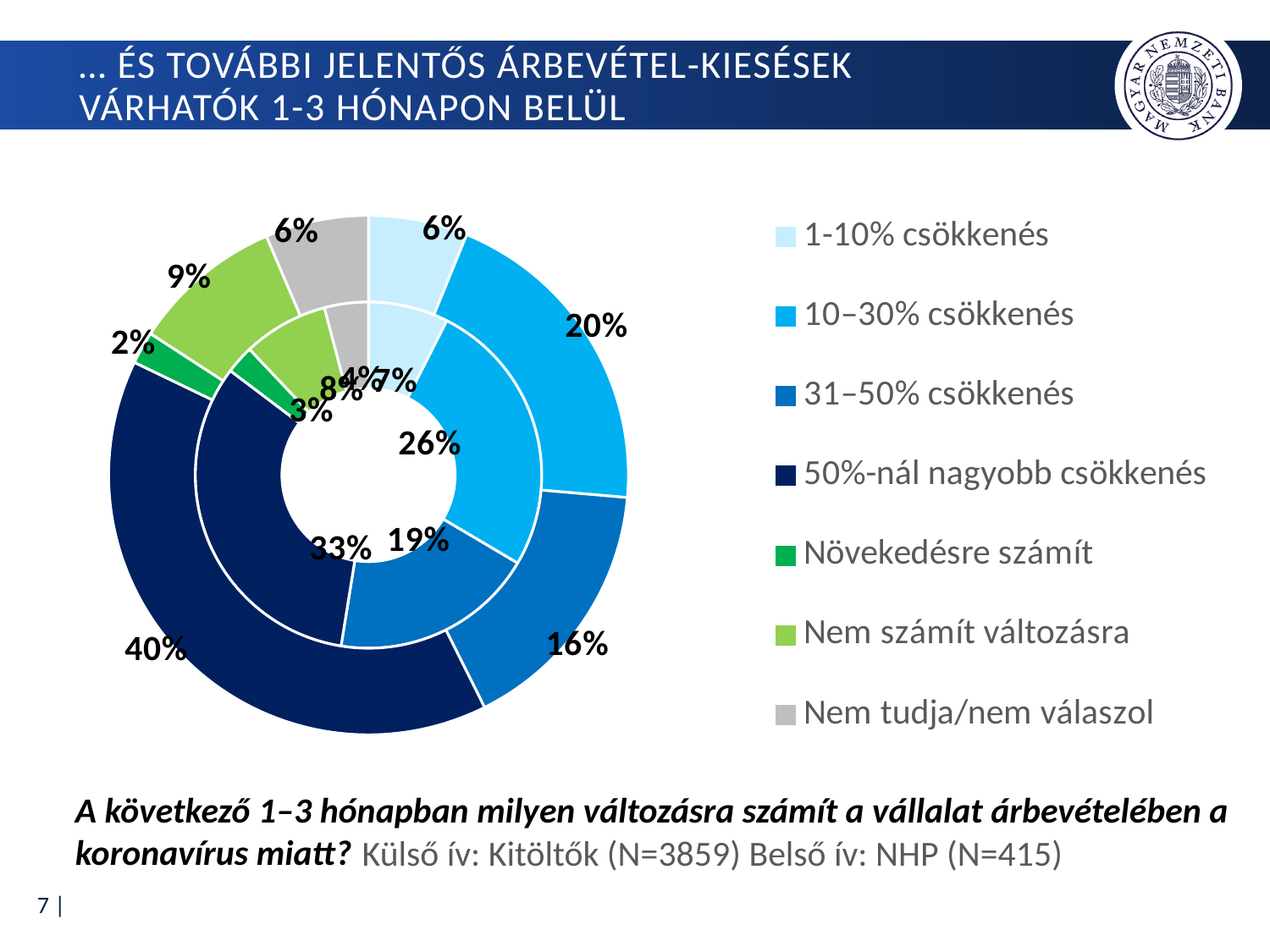
What is the difference between the outer ring (40%) and inner ring (33%) shares for a decrease greater than 50%? 7 percentage points In the inner ring (NHP), what share of respondents expect a decrease greater than 50%? 33% In the outer ring (Kitöltők), what share of respondents expect growth (Növekedésre számít)? 2% In the outer ring (Kitöltők), what share of respondents expect a decrease greater than 50% (50%-nál nagyobb csökkenés)? 40% In the inner ring (NHP), what share of respondents expect a 10–30% decrease? 26% In the outer ring (Kitöltők), what share of respondents expect no change (Nem számít változásra)? 9% In the outer ring (Kitöltők), what share of respondents expect a 31–50% decrease? 16% Which category has the largest share in the outer ring (Kitöltők)? 50%-nál nagyobb csökkenés What kind of chart is shown on the slide? Doughnut (pie) chart In the outer ring (Kitöltők), what share of respondents expect a 10–30% decrease? 20% Which category has the smallest share in the outer ring (Kitöltők)? Növekedésre számít How many categories does the legend list? 7